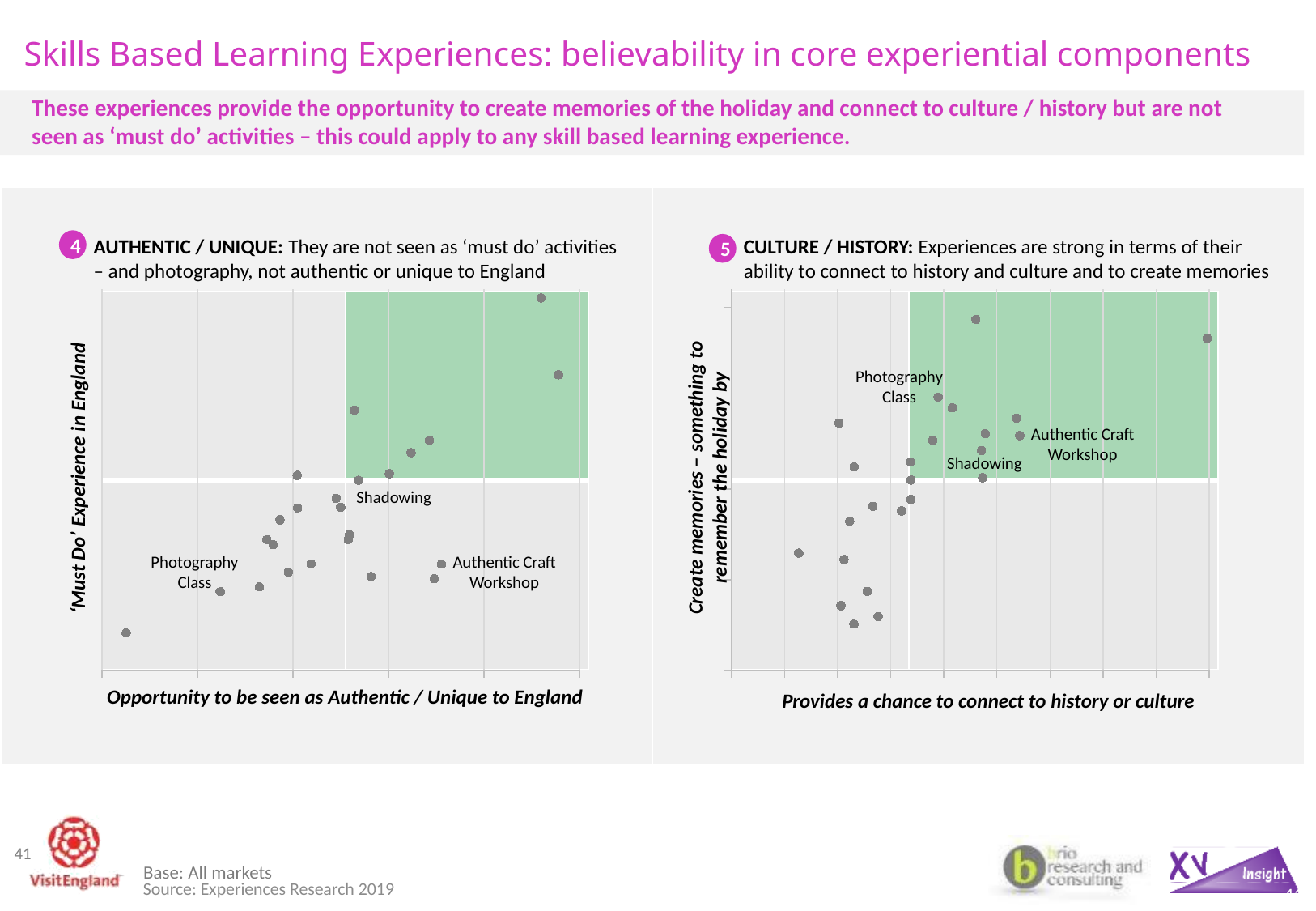
What kind of chart is the right chart (CULTURE / HISTORY)? Scatter chart In the right chart (CULTURE / HISTORY), which of the labelled points is lowest on the vertical axis? Shadowing In the left chart (AUTHENTIC / UNIQUE), which is plotted higher on the vertical axis, Shadowing or Photography Class? Shadowing In the right chart (CULTURE / HISTORY), how many points are labelled with a name? 3 What kind of chart is the left chart (AUTHENTIC / UNIQUE)? Scatter chart In the left chart (AUTHENTIC / UNIQUE), what is the title of the horizontal axis? Opportunity to be seen as Authentic / Unique to England In the left chart (AUTHENTIC / UNIQUE), how many points are labelled with a name? 3 In the left chart (AUTHENTIC / UNIQUE), which of the labelled points is furthest to the right on the horizontal axis? Authentic Craft Workshop In the right chart (CULTURE / HISTORY), which of the labelled points is highest on the vertical axis? Photography Class In the right chart (CULTURE / HISTORY), which is plotted further to the right, Authentic Craft Workshop or Shadowing? Authentic Craft Workshop In the right chart (CULTURE / HISTORY), what is the title of the vertical axis? Create memories – something to remember the holiday by In the left chart (AUTHENTIC / UNIQUE), which of the labelled points is lowest on the vertical axis? Photography Class